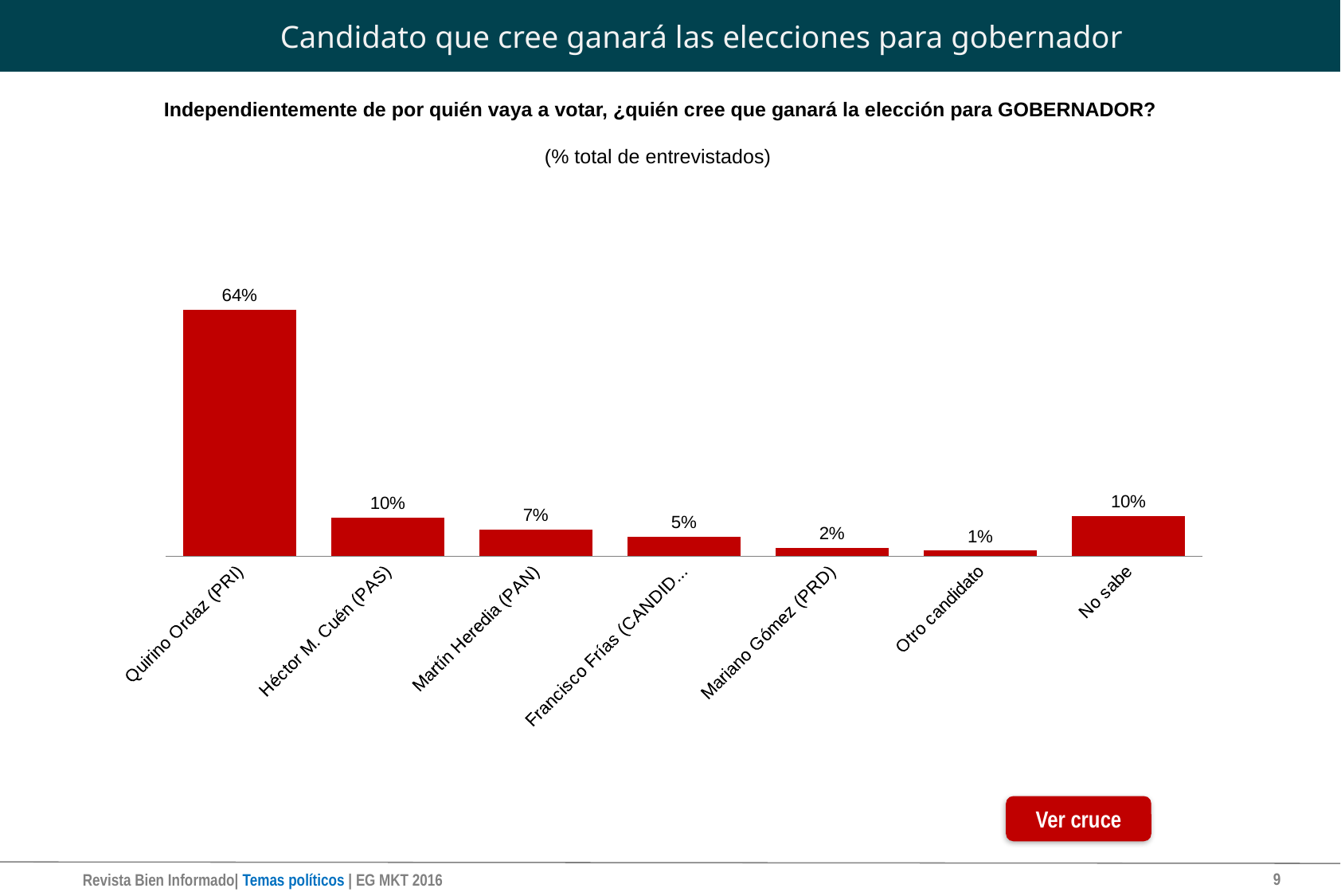
What is the value shown for Martín Heredia (PAN)? 7% Which is larger, the value for Martín Heredia (PAN) or the value for Mariano Gómez (PRD)? Martín Heredia (PAN) How many categories are shown in the chart? 7 Which category has the lowest value in the chart? Otro candidato Which category has the highest value in the chart? Quirino Ordaz (PRI) What colour are the bars in the chart? Red What percentage of respondents believe Quirino Ordaz (PRI) will win the election for governor? 64% What is the difference between the values for Martín Heredia (PAN) and Mariano Gómez (PRD)? 5% What is the difference between the values for Quirino Ordaz (PRI) and Héctor M. Cuén (PAS)? 54% What kind of chart is shown on the slide? Bar chart What is the value shown for Héctor M. Cuén (PAS)? 10% What percentage of respondents answered 'No sabe'? 10%